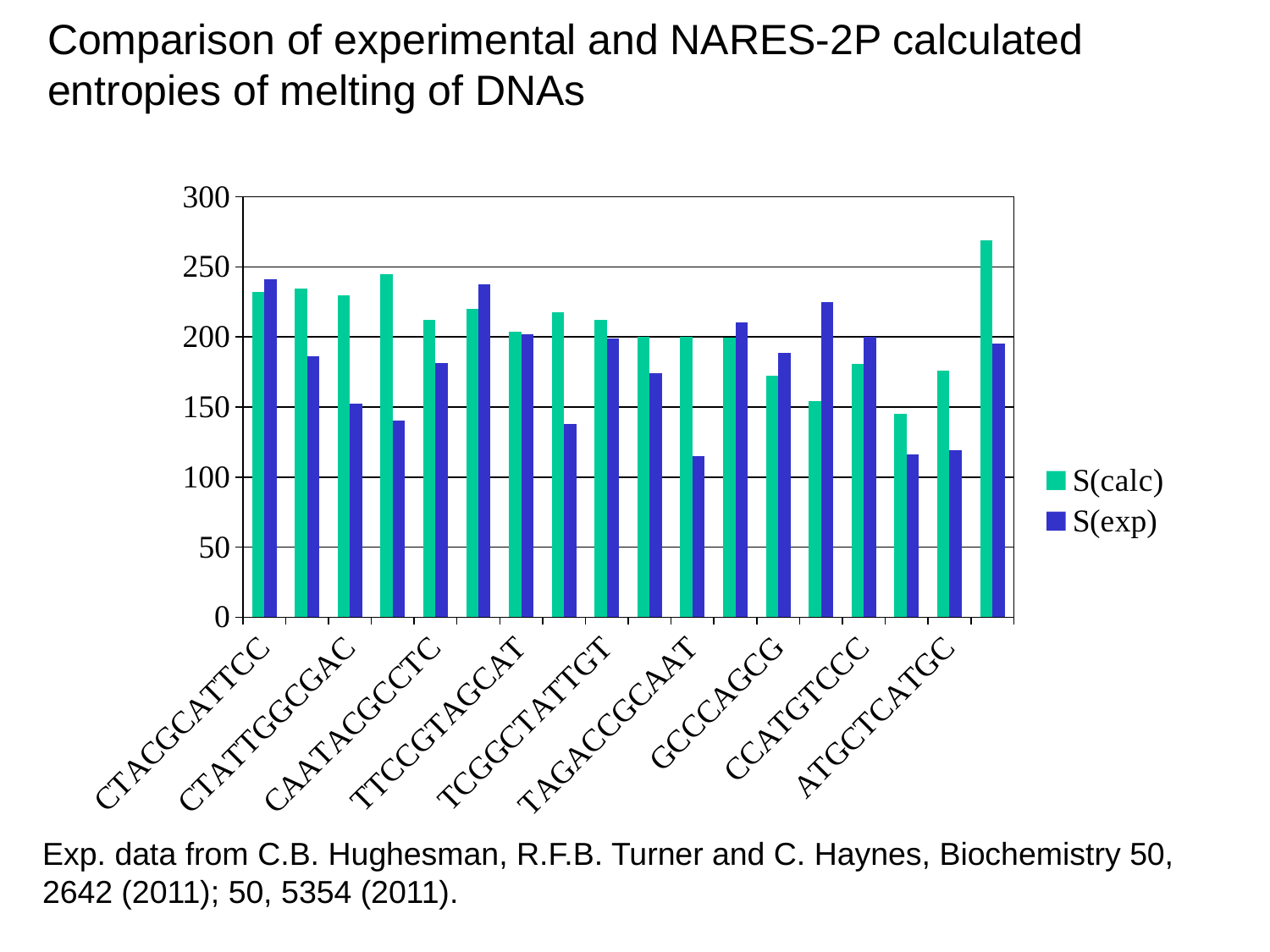
Is the S(calc) value for GCCCAGCG greater or less than 200? less What is the maximum value shown on the y axis? 300 For CTATTGGCGAC, which is larger, S(calc) or S(exp)? S(calc) Is the tallest S(calc) bar on the chart greater or less than 250? greater Is the S(exp) value for ATGCTCATGC greater or less than 150? less What kind of chart is shown on the slide? bar chart What are the two series named in the legend? S(calc) and S(exp) For CCATGTCCC, which is larger, S(calc) or S(exp)? S(exp) How many series does the legend list? 2 For CAATACGCCTC, which is larger, S(calc) or S(exp)? S(calc)